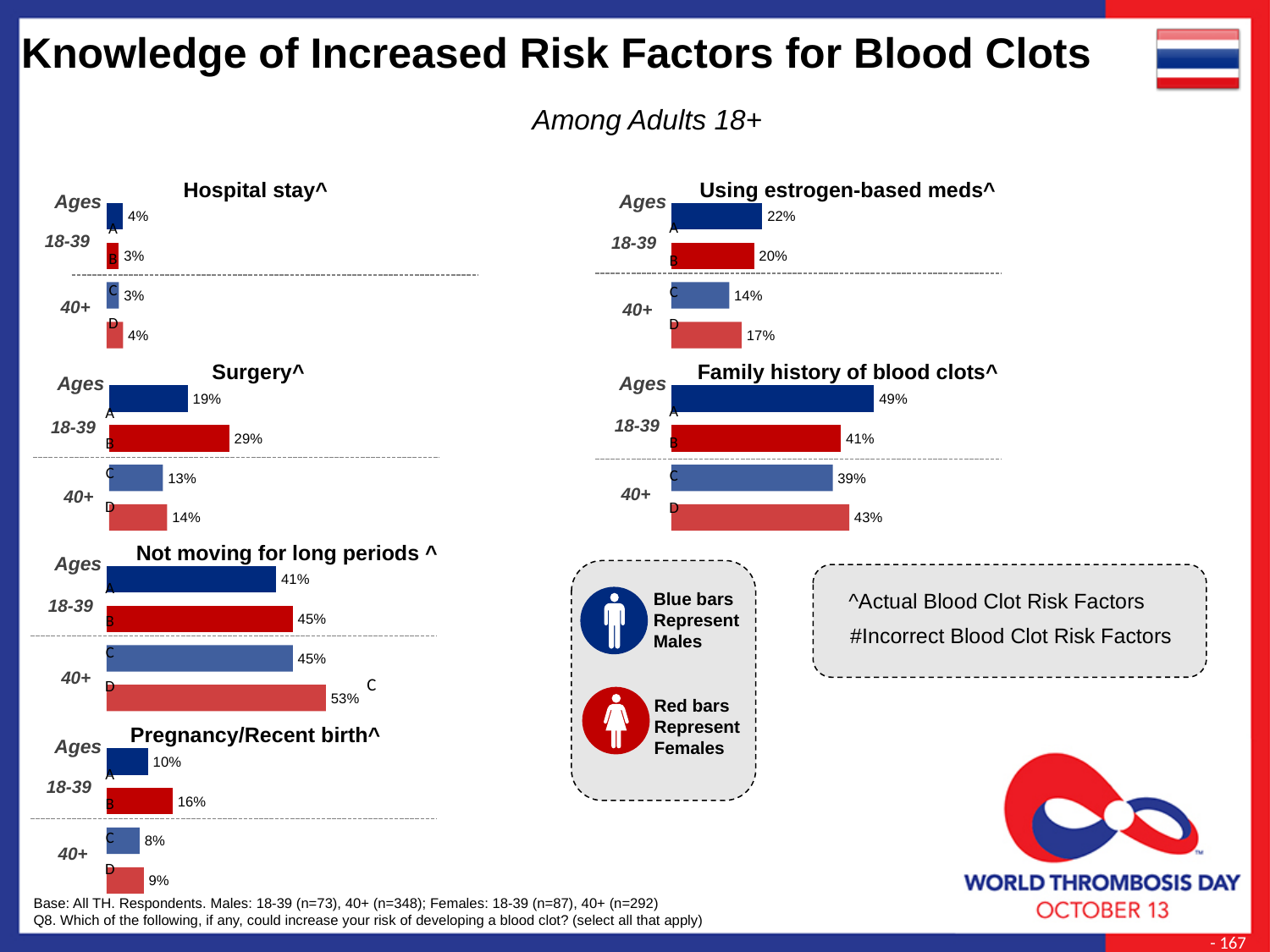
In the 'Family history of blood clots^' chart, which bar has the lowest value? C (males 40+), 39% In the 'Family history of blood clots^' chart, what is the value for males aged 18-39 (bar A)? 49% In the 'Pregnancy/Recent birth^' chart, which bar has the highest value? B (females 18-39), 16% In the 'Using estrogen-based meds^' chart, which is larger: the value for bar A or bar B? Bar A (22%) In the 'Not moving for long periods ^' chart, what is the difference between the values for bar D and bar A? 12 percentage points According to the legend box, what do the red bars represent? Females In the 'Surgery^' chart, what is the value for females aged 18-39 (bar B)? 29% How many bars are shown in the 'Hospital stay^' chart? 4 In the 'Not moving for long periods ^' chart, what is the value for females aged 40+ (bar D)? 53% In the 'Surgery^' chart, what is the difference between the values for bar B and bar A? 10 percentage points What type of chart is used for 'Family history of blood clots^'? Bar chart In the 'Using estrogen-based meds^' chart, what is the value for males aged 40+ (bar C)? 14%